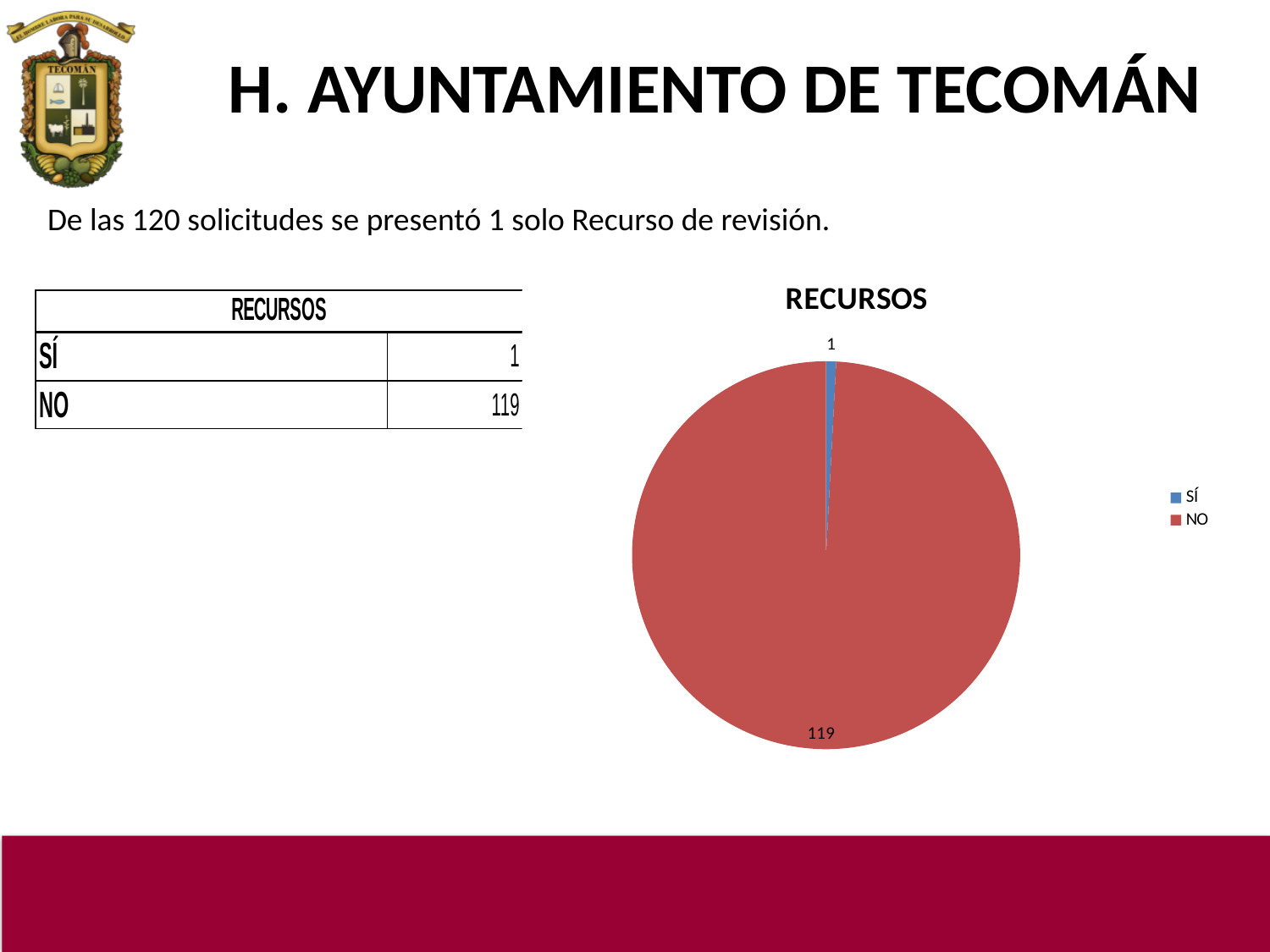
What is the title of the chart? RECURSOS Which colour represents NO in the pie chart? red Which category has the smallest slice in the pie chart? SÍ Which is larger, the value for SÍ or the value for NO? NO What is the total of all slices in the pie chart? 120 What is the value for NO in the pie chart? 119 What is the difference between the values for NO and SÍ? 118 What is the value for SÍ in the pie chart? 1 Which category has the largest slice in the pie chart? NO What kind of chart is shown on the slide? pie chart How many slices does the pie chart have? 2 How many entries does the legend list? 2